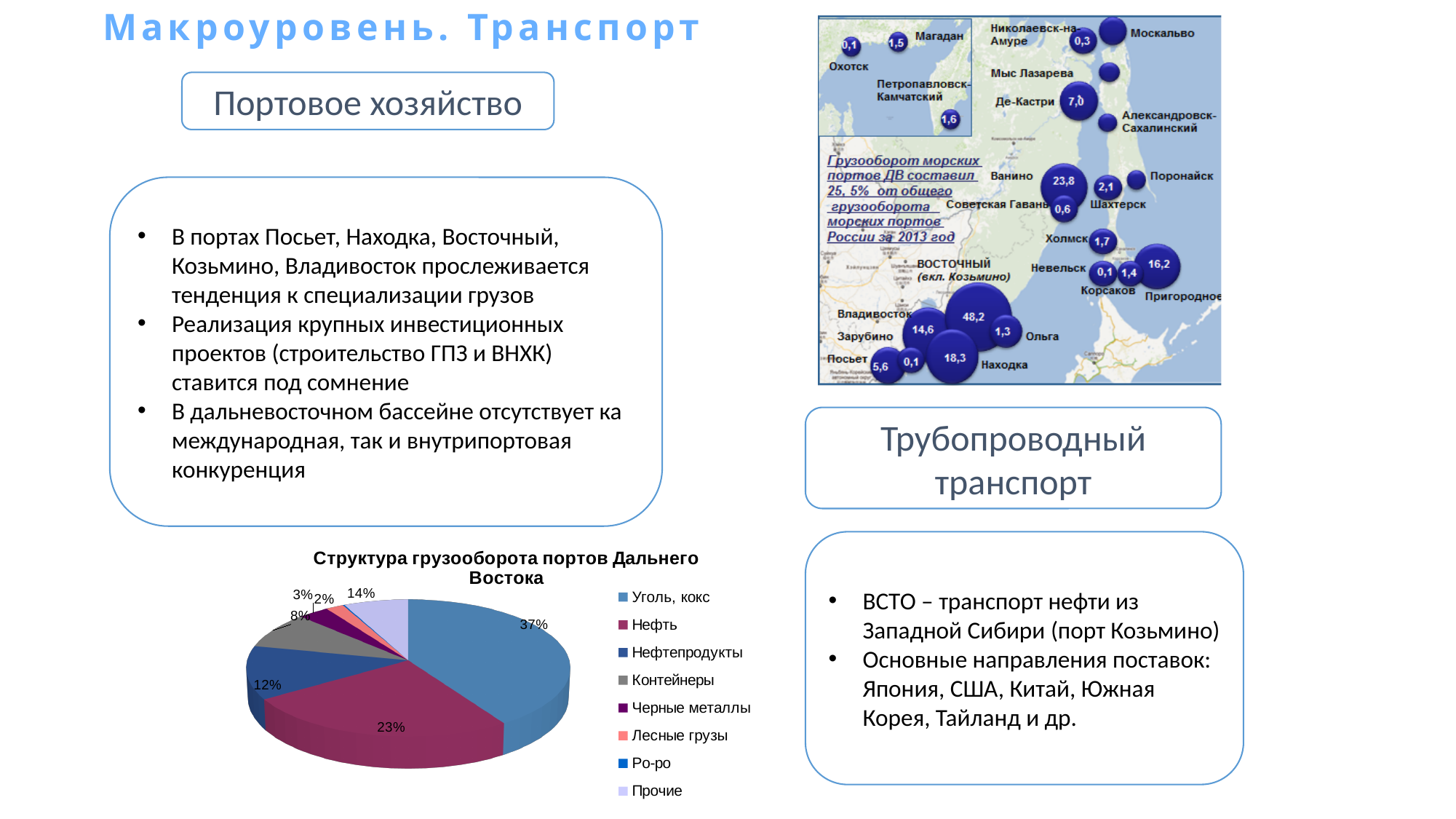
On the map in the top right, what value is shown for 'Восточный (вкл. Козьмино)'? 48,2 What kind of chart is 'Структура грузооборота портов Дальнего Востока'? Pie chart In the pie chart 'Структура грузооборота портов Дальнего Востока', how many percentage points larger is 'Уголь, кокс' than 'Нефть'? 14 percentage points In the pie chart 'Структура грузооборота портов Дальнего Востока', which category has the largest share? Уголь, кокс In the pie chart 'Структура грузооборота портов Дальнего Востока', how many percentage points larger is 'Нефть' than 'Нефтепродукты'? 11 percentage points In the pie chart 'Структура грузооборота портов Дальнего Востока', which is larger: 'Нефтепродукты' or 'Контейнеры'? Нефтепродукты In the pie chart 'Структура грузооборота портов Дальнего Востока', what share does 'Нефть' have? 23% How many categories does the legend of the pie chart 'Структура грузооборота портов Дальнего Востока' list? 8 On the map in the top right, what value is shown for 'Ванино'? 23,8 In the pie chart 'Структура грузооборота портов Дальнего Востока', what share does 'Контейнеры' have? 8% In the pie chart 'Структура грузооборота портов Дальнего Востока', what share does 'Уголь, кокс' have? 37% In the pie chart 'Структура грузооборота портов Дальнего Востока', what share does 'Прочие' have? 14%